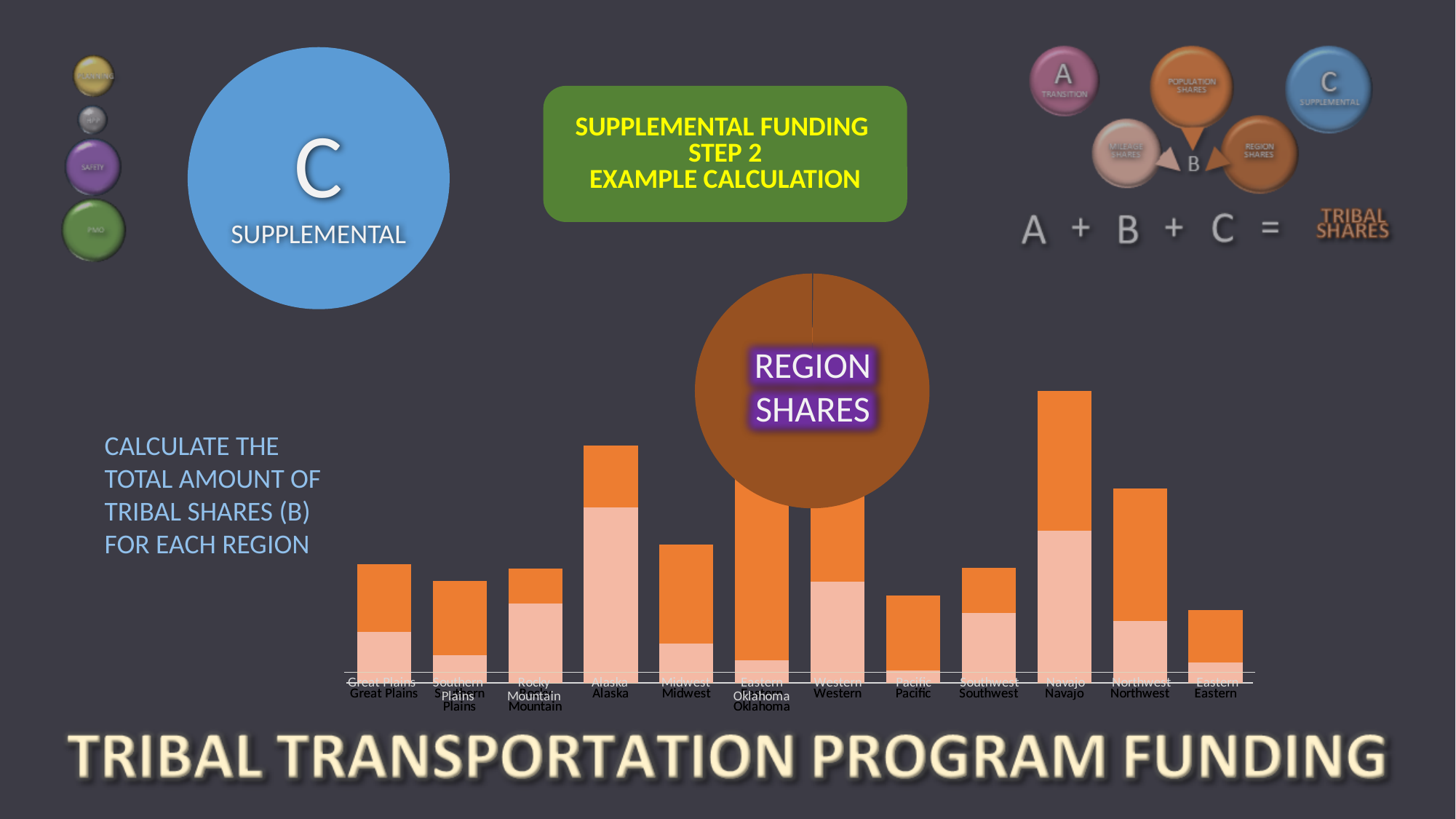
Which region has the shortest bar in the chart? Eastern Which bar is taller, Navajo or Alaska? Navajo Which bar is taller, Midwest or Pacific? Midwest Which bar is taller, Alaska or Western? Alaska What label appears in the brown circle above the bar chart? REGION SHARES What kind of chart is shown at the bottom of the slide? Stacked bar chart How many regions are shown along the x axis of the bar chart? 12 How many coloured segments make up each bar in the chart? 2